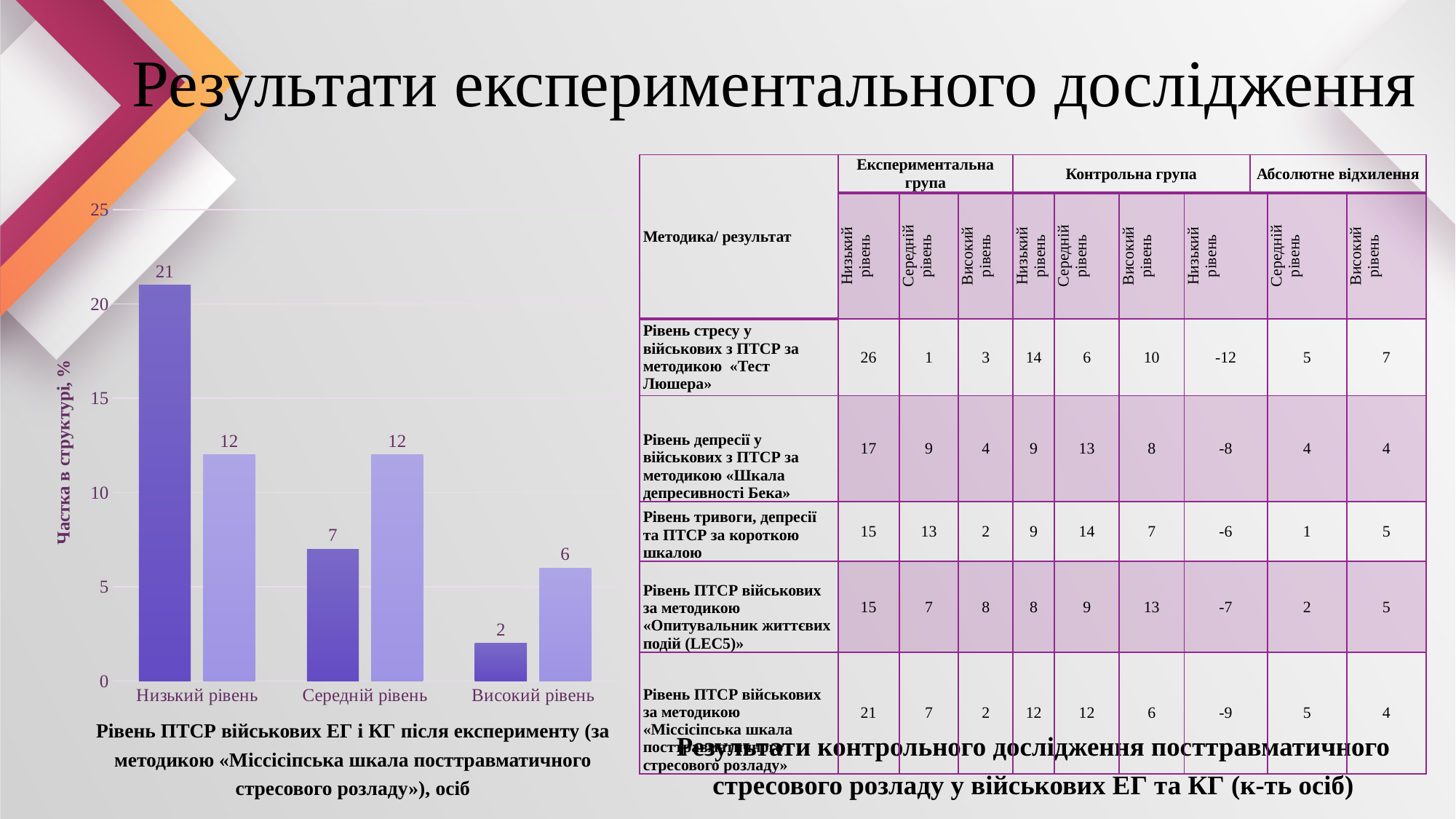
How many categories are shown on the x axis? 3 Do the dark purple bars rise or fall from Низький рівень to Високий рівень? fall What is the difference between the dark purple and light purple bars for Низький рівень? 9 What is the value of the dark purple bar for Низький рівень? 21 For Середній рівень, which bar is larger, the dark purple or the light purple one? light purple Which category has the highest dark purple bar? Низький рівень What kind of chart is shown on the slide? bar chart What is the label of the vertical axis of the chart? Частка в структурі, % What is the value of the light purple bar for Високий рівень? 6 What is the value of the dark purple bar for Високий рівень? 2 What is the value of the light purple bar for Середній рівень? 12 Which category has the lowest light purple bar? Високий рівень